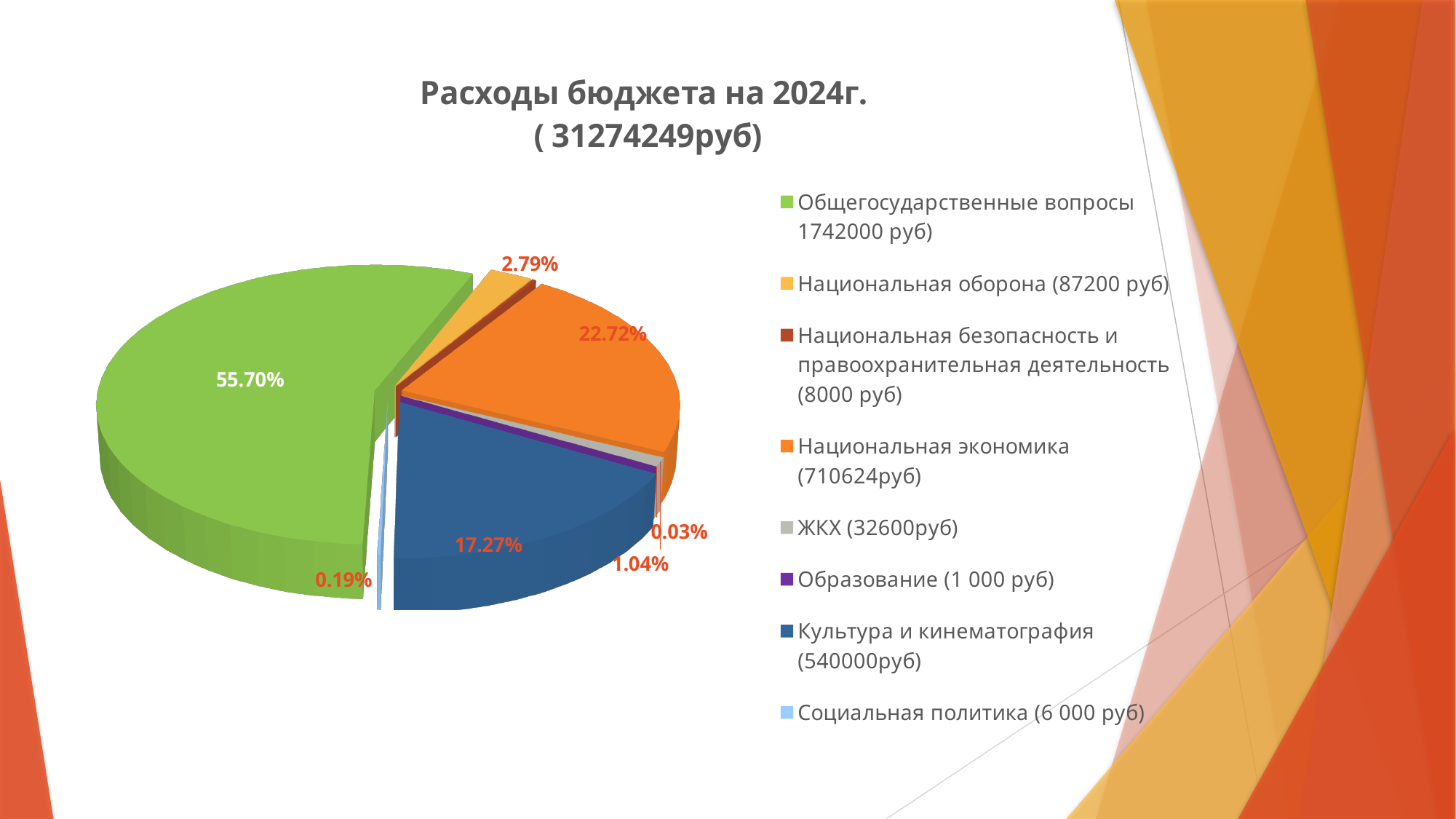
How many categories does the legend list? 8 What share of the pie does Социальная политика take? 0.19% Which category has the largest slice of the pie? Общегосударственные вопросы What share of the pie does Культура и кинематография take? 17.27% What kind of chart is shown on the slide? pie chart What share of the pie does Общегосударственные вопросы take? 55.70% What is the title of the chart? Расходы бюджета на 2024г. ( 31274249руб) What is the difference in percentage points between the Общегосударственные вопросы slice and the Национальная экономика slice? 32.98% Which slice is larger: Национальная экономика or Культура и кинематография? Национальная экономика What colour is the slice for Культура и кинематография? blue